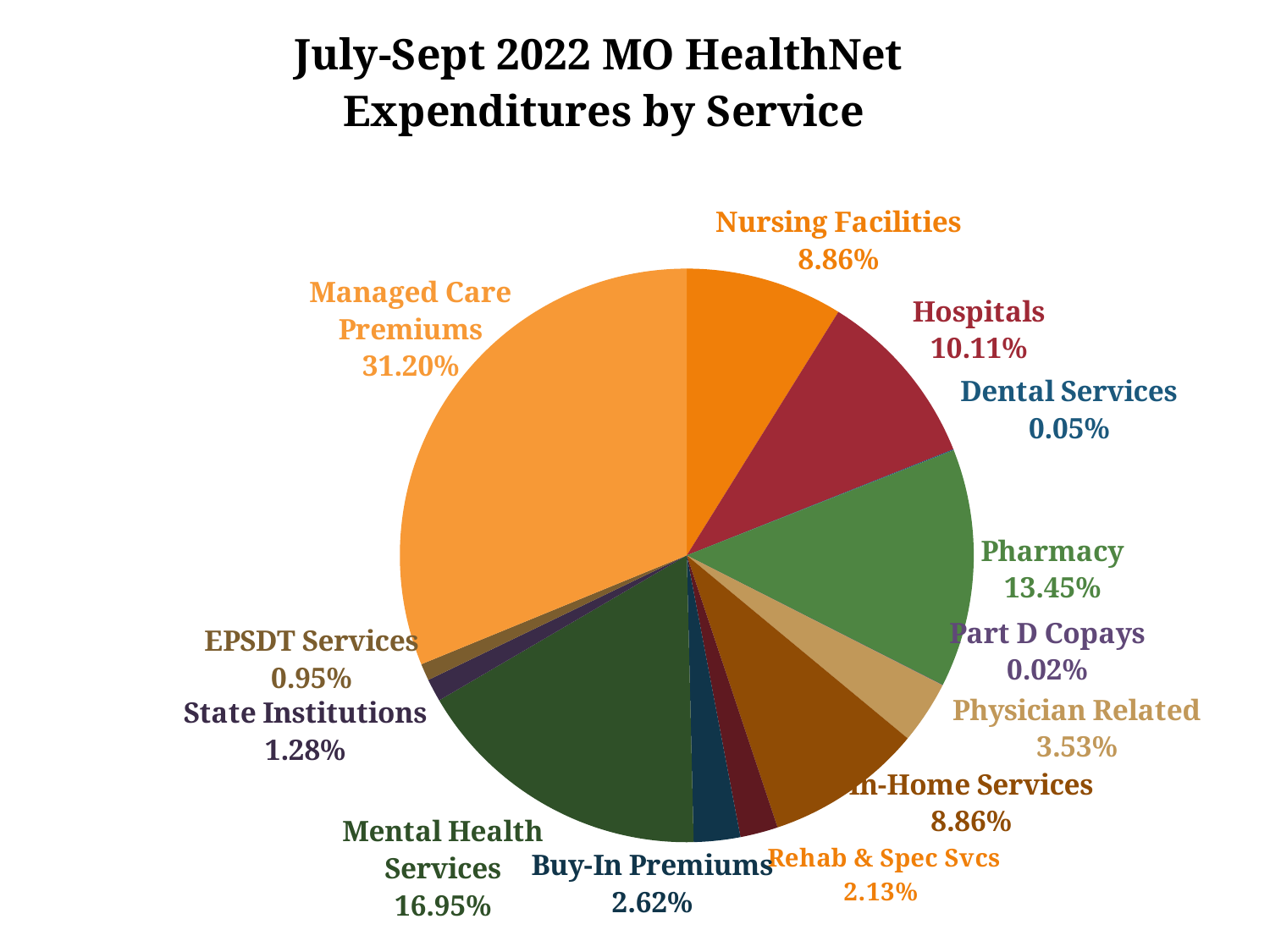
How many service categories are shown in the pie chart? 13 What is the title of the chart? July-Sept 2022 MO HealthNet Expenditures by Service What is the value shown for Mental Health Services? 16.95% What kind of chart is shown on the slide? Pie chart Which service category has the smallest share of expenditures? Part D Copays Which service category has the largest share of expenditures? Managed Care Premiums What percentage of expenditures goes to Pharmacy? 13.45% Which is larger, the share for Pharmacy or the share for Hospitals? Pharmacy What is the difference in percentage points between Managed Care Premiums and Mental Health Services? 14.25 What share of expenditures is Managed Care Premiums? 31.20% What percentage is shown for Hospitals? 10.11% What is the difference in percentage points between Physician Related and Rehab & Spec Svcs? 1.40